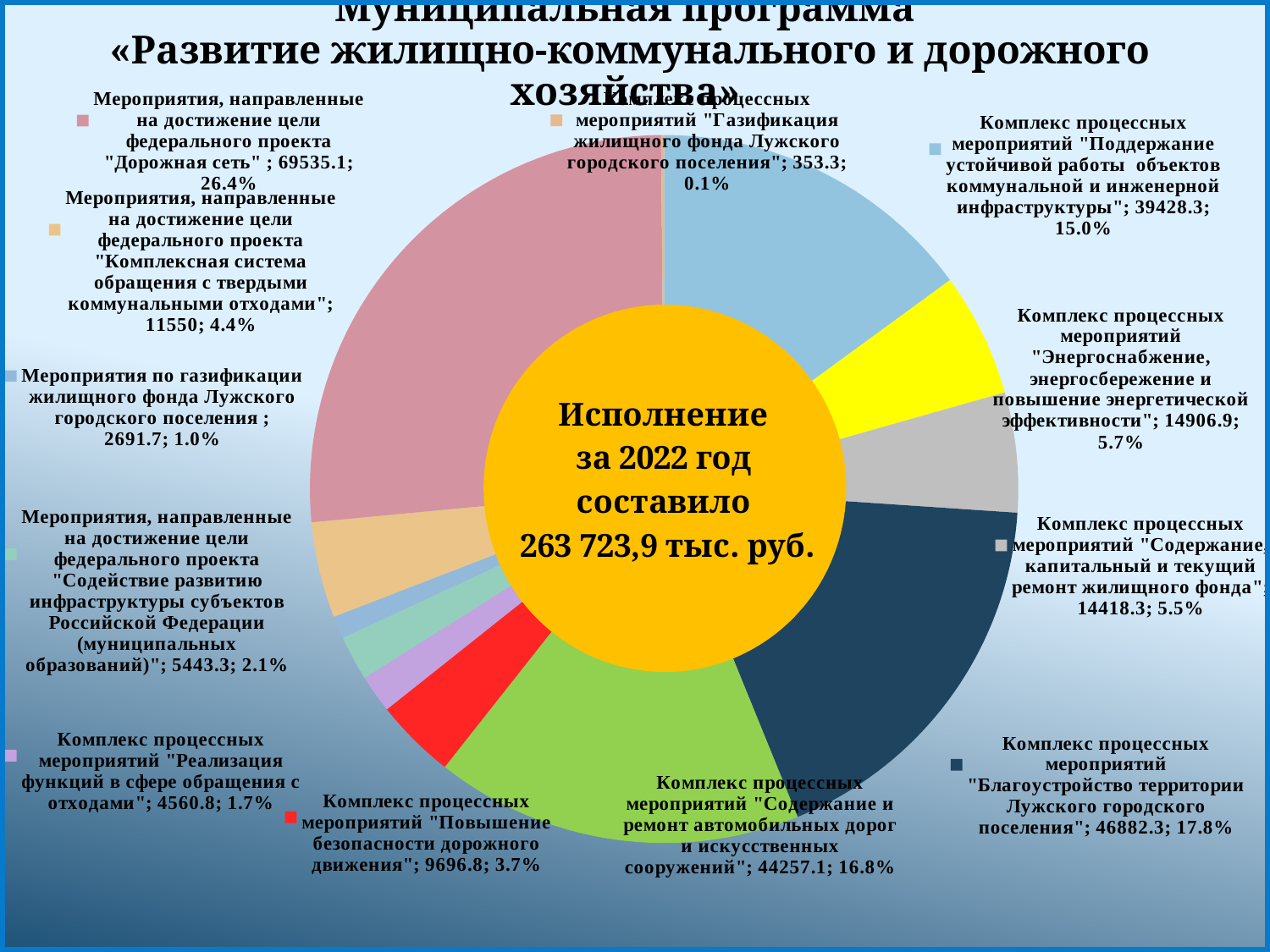
Which category has the smallest value in the pie chart? Комплекс процессных мероприятий "Газификация жилищного фонда Лужского городского поселения" What share of the pie does "Поддержание устойчивой работы объектов коммунальной и инженерной инфраструктуры" represent? 15.0% What is the value for the category "Дорожная сеть"? 69535.1 What share of the pie does "Содержание и ремонт автомобильных дорог и искусственных сооружений" represent? 16.8% How many categories (slices) does the pie chart contain? 12 Which category has the largest value in the pie chart? Мероприятия, направленные на достижение цели федерального проекта "Дорожная сеть" Which is larger: the value for "Энергоснабжение, энергосбережение и повышение энергетической эффективности" or the value for "Содержание, капитальный и текущий ремонт жилищного фонда"? Энергоснабжение, энергосбережение и повышение энергетической эффективности What is the value for the category "Повышение безопасности дорожного движения"? 9696.8 What is the difference between the values for "Благоустройство территории Лужского городского поселения" and "Содержание и ремонт автомобильных дорог и искусственных сооружений"? 2625.2 What total amount is stated in the centre of the pie chart? 263 723,9 тыс. руб. What is the value for the category "Благоустройство территории Лужского городского поселения"? 46882.3 What kind of chart is shown on the slide? doughnut chart